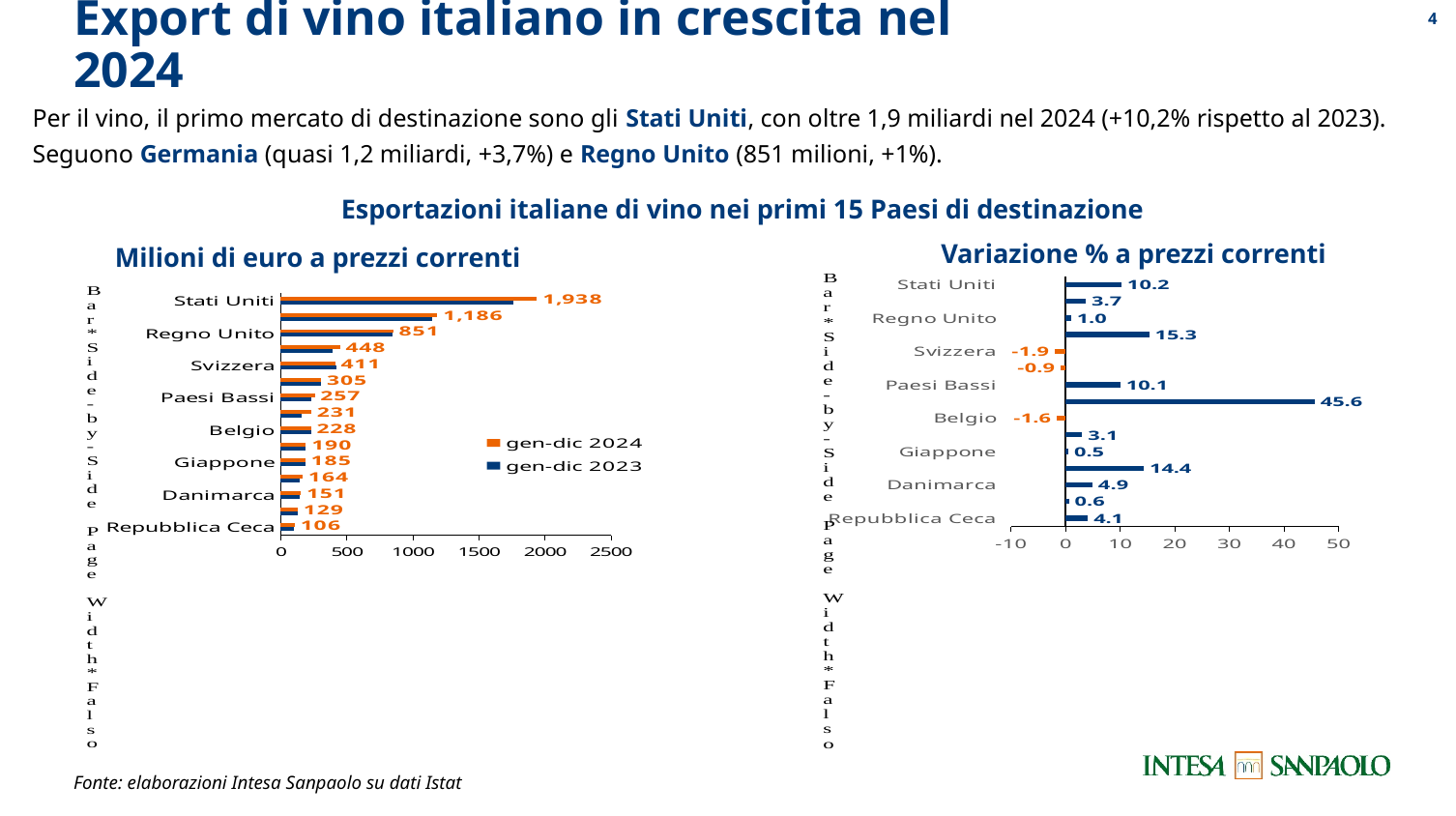
What kind of chart is 'Variazione % a prezzi correnti'? Bar chart In the chart 'Variazione % a prezzi correnti', what is the value for Danimarca? 4.9 In the chart 'Milioni di euro a prezzi correnti', which has the larger value, Svizzera or Paesi Bassi? Svizzera In the chart 'Milioni di euro a prezzi correnti', what value is labelled for Stati Uniti? 1,938 In the chart 'Milioni di euro a prezzi correnti', which country has the highest value? Stati Uniti In the chart 'Variazione % a prezzi correnti', what is the value for Svizzera? -1.9 In the chart 'Milioni di euro a prezzi correnti', what value is labelled for Regno Unito? 851 In the chart 'Milioni di euro a prezzi correnti', what is the difference between the labelled values for Stati Uniti and Regno Unito? 1,087 In the chart 'Variazione % a prezzi correnti', what is the highest value shown? 45.6 In the chart 'Milioni di euro a prezzi correnti', which country has the lowest value? Repubblica Ceca In the chart 'Variazione % a prezzi correnti', which has the larger value, Giappone or Danimarca? Danimarca In the chart 'Milioni di euro a prezzi correnti', how many series does the legend list? 2